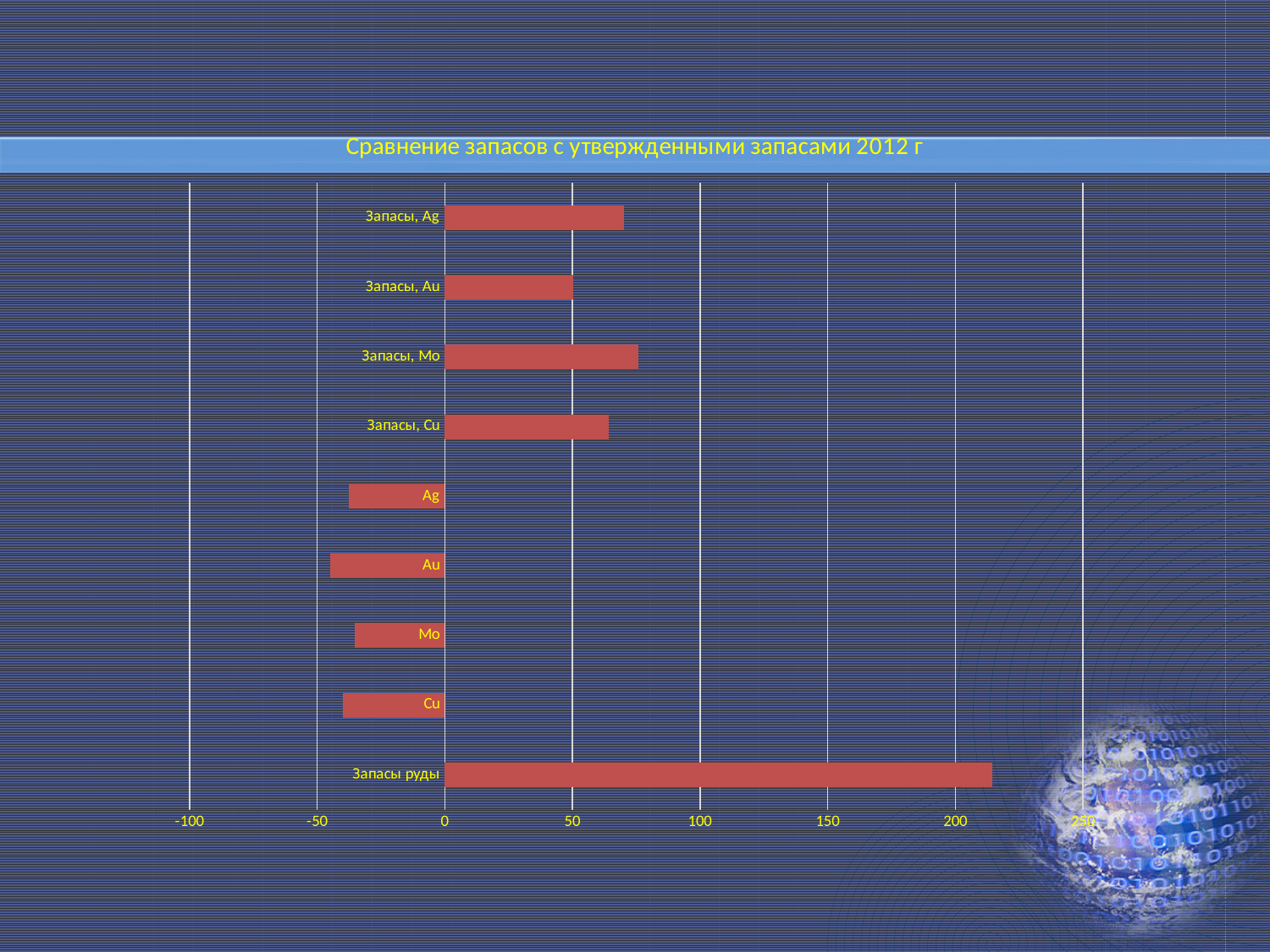
Which is larger, the value for Запасы, Cu or the value for Cu? Запасы, Cu Is the value for Запасы руды greater or less than 250? less How many categories are plotted in the chart? 9 Is the value for Ag greater or less than 0? less What is the title of the chart? Сравнение запасов с утвержденными запасами 2012 г Is the value for Запасы, Ag greater or less than 50? greater Which category has the highest value? Запасы руды Which is larger, the value for Запасы, Mo or the value for Запасы, Au? Запасы, Mo What kind of chart is shown on the slide? bar chart